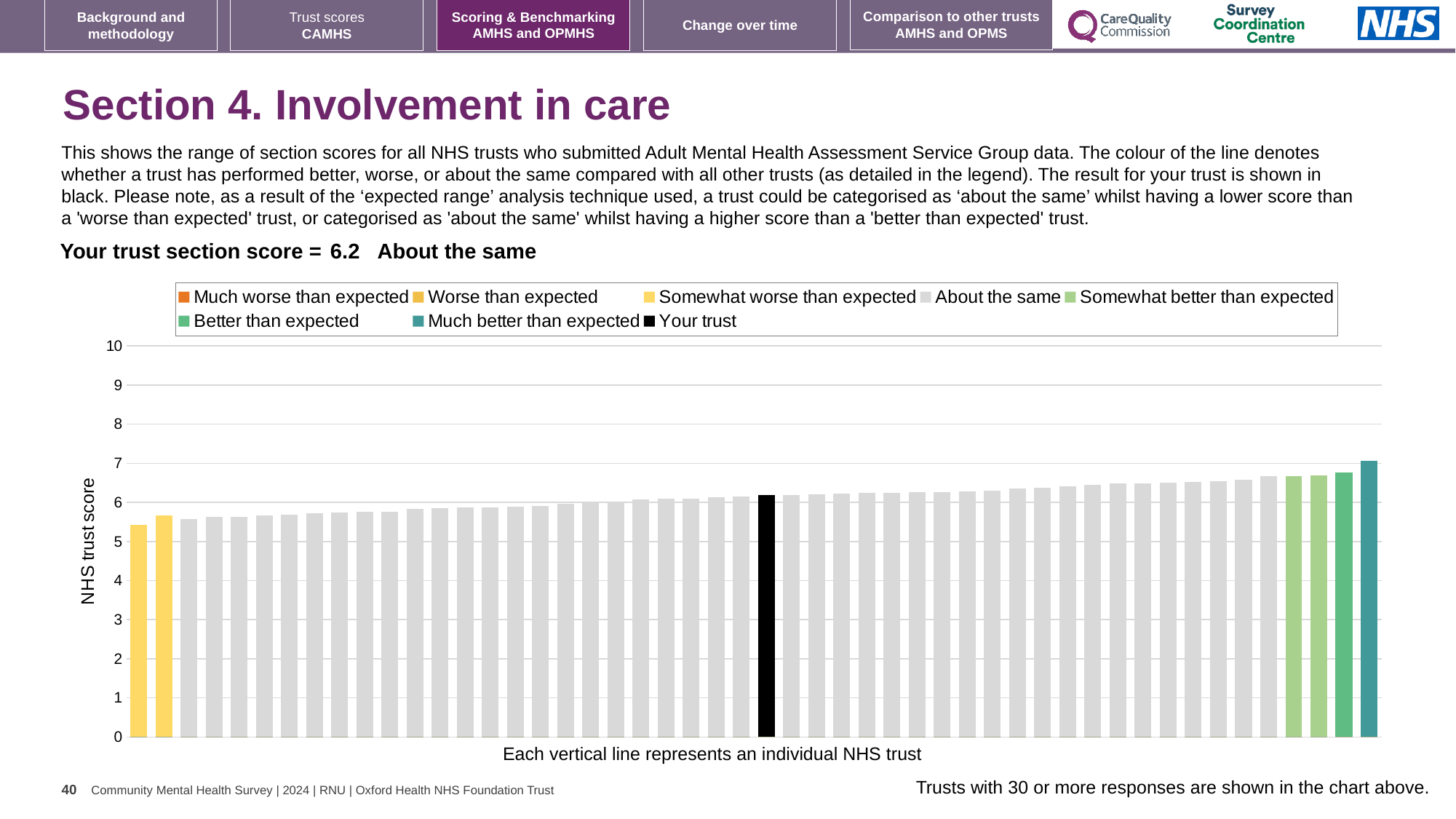
What kind of chart is shown on the slide? bar chart Which category is your trust's section score placed in? About the same Is the value for your trust (the black bar) greater or less than 5? greater Which is larger: the black bar for your trust or the leftmost yellow bar? the black bar for your trust How many bars are coloured as 'Much better than expected' (teal)? 1 What is the label on the vertical axis of the chart? NHS trust score What is the section score for your trust shown on the slide? 6.2 Is the value of the lowest bar in the chart greater or less than 6? less Do the bar values rise or fall from left to right across the chart? rise Is the value of the highest bar in the chart greater or less than 6? greater How many entries does the chart legend list? 8